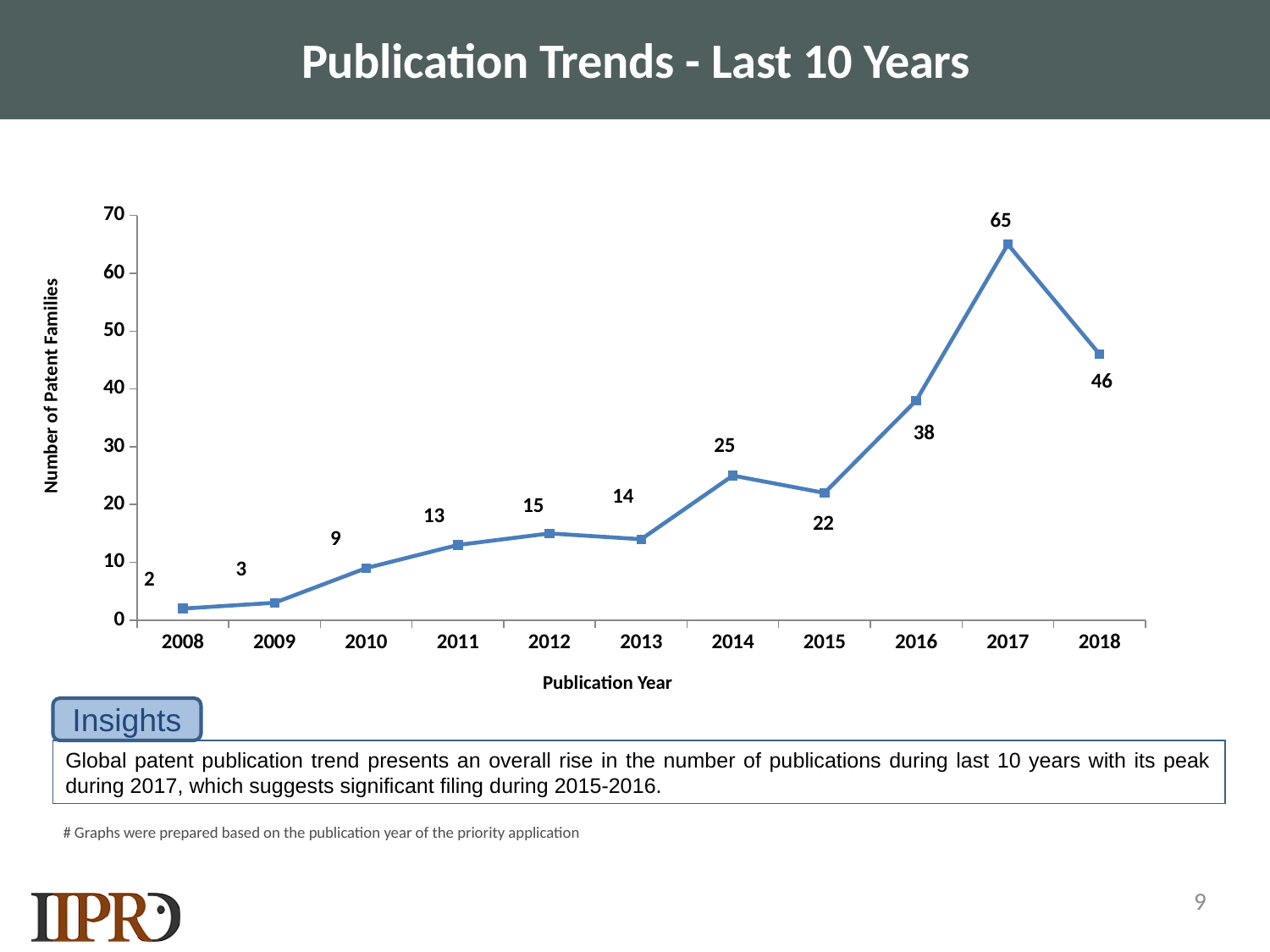
What is the number of patent families for 2012? 15 Which publication year has the lowest number of patent families? 2008 Do the values rise or fall from 2008 to 2017? rise What is the number of patent families for 2017? 65 What kind of chart is shown on the slide? line chart Which year has more patent families, 2014 or 2015? 2014 What is the difference in the number of patent families between 2017 and 2018? 19 How many publication years are plotted on the chart? 11 What is the label of the y axis? Number of Patent Families What is the title of the chart? Publication Trends - Last 10 Years Is the value for 2016 greater or less than 30? greater Which publication year has the highest number of patent families? 2017